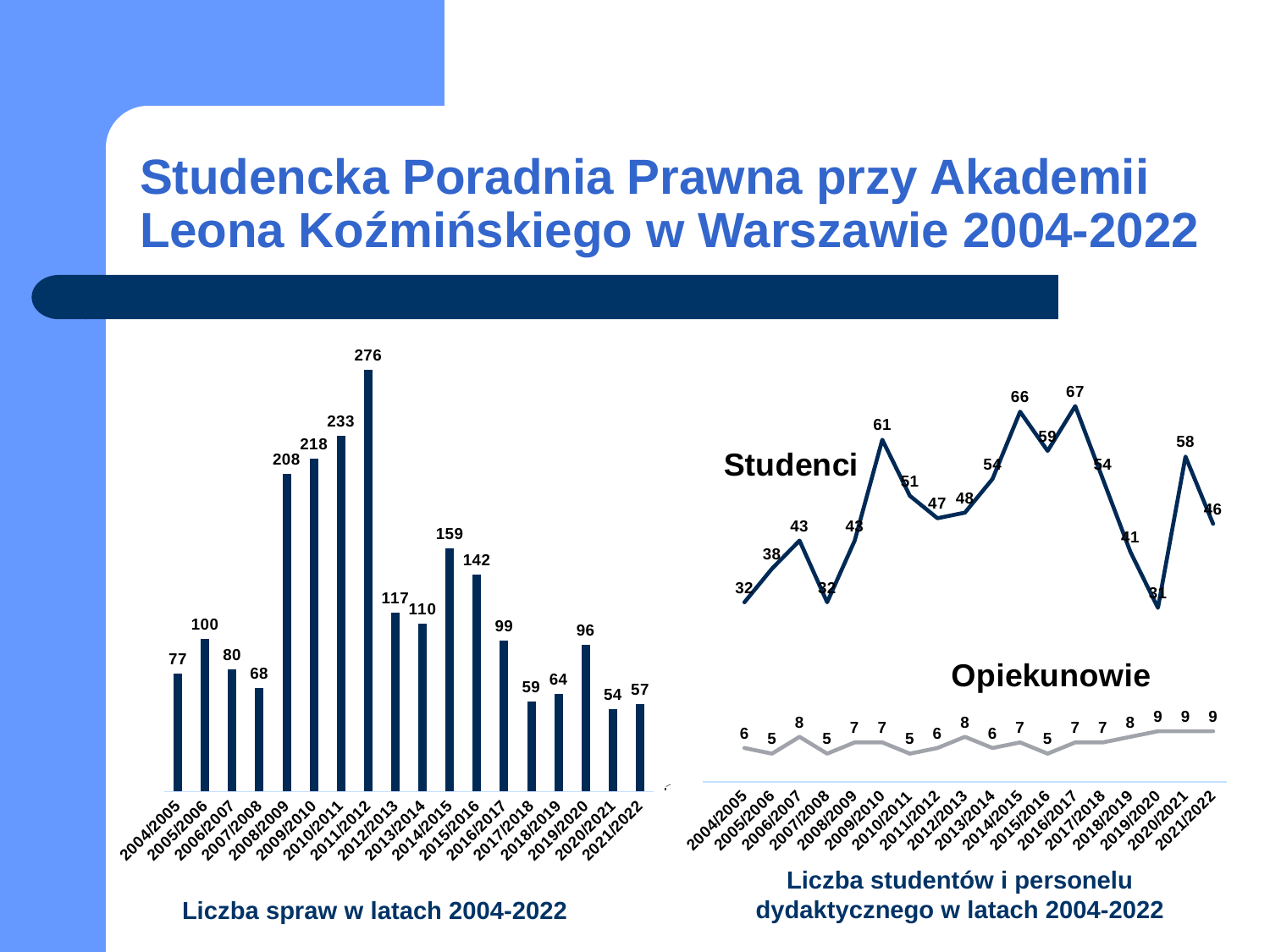
How many years are shown in the chart 'Liczba spraw w latach 2004-2022'? 18 What type of chart is 'Liczba spraw w latach 2004-2022'? bar chart In the chart 'Liczba spraw w latach 2004-2022', what is the difference between the values for 2010/2011 and 2009/2010? 15 In the chart 'Liczba spraw w latach 2004-2022', which year has the lowest value? 2020/2021 In the chart 'Liczba spraw w latach 2004-2022', what is the value for 2011/2012? 276 In the chart 'Liczba spraw w latach 2004-2022', what is the value for 2014/2015? 159 What type of chart is 'Liczba studentów i personelu dydaktycznego w latach 2004-2022'? line chart In the chart 'Liczba studentów i personelu dydaktycznego w latach 2004-2022', what is the Studenci value for 2016/2017? 67 In the chart 'Liczba spraw w latach 2004-2022', which year has the highest value? 2011/2012 In the chart 'Liczba studentów i personelu dydaktycznego w latach 2004-2022', what is the Opiekunowie value for 2021/2022? 9 In the chart 'Liczba studentów i personelu dydaktycznego w latach 2004-2022', which year has the highest Studenci value? 2016/2017 In the chart 'Liczba spraw w latach 2004-2022', which is larger, the value for 2012/2013 or the value for 2013/2014? 2012/2013